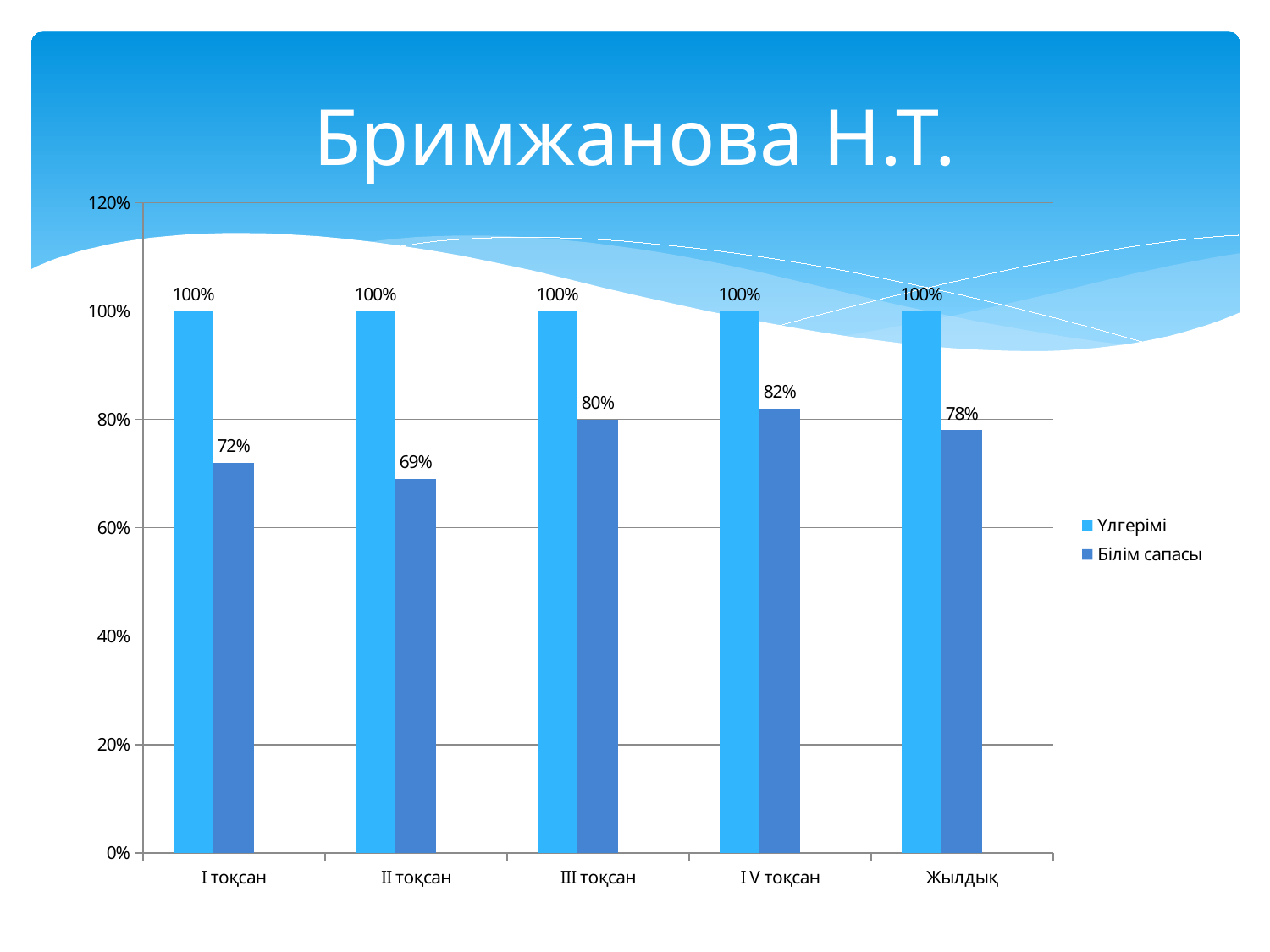
How many series does the legend list? 2 What is the difference between the Білім сапасы values for I V тоқсан and Жылдық? 4% Which category has the highest Білім сапасы value? I V тоқсан What is the difference between Үлгерімі and Білім сапасы for II тоқсан? 31% Which is larger, the Білім сапасы value for I тоқсан or for III тоқсан? III тоқсан What kind of chart is shown on the slide? Bar chart What is the value of Білім сапасы for I тоқсан? 72% Which category has the lowest Білім сапасы value? II тоқсан What is the title of the slide? Бримжанова Н.Т. What is the value of Үлгерімі for Жылдық? 100% What is the value of Білім сапасы for III тоқсан? 80% How many categories are shown on the x axis? 5